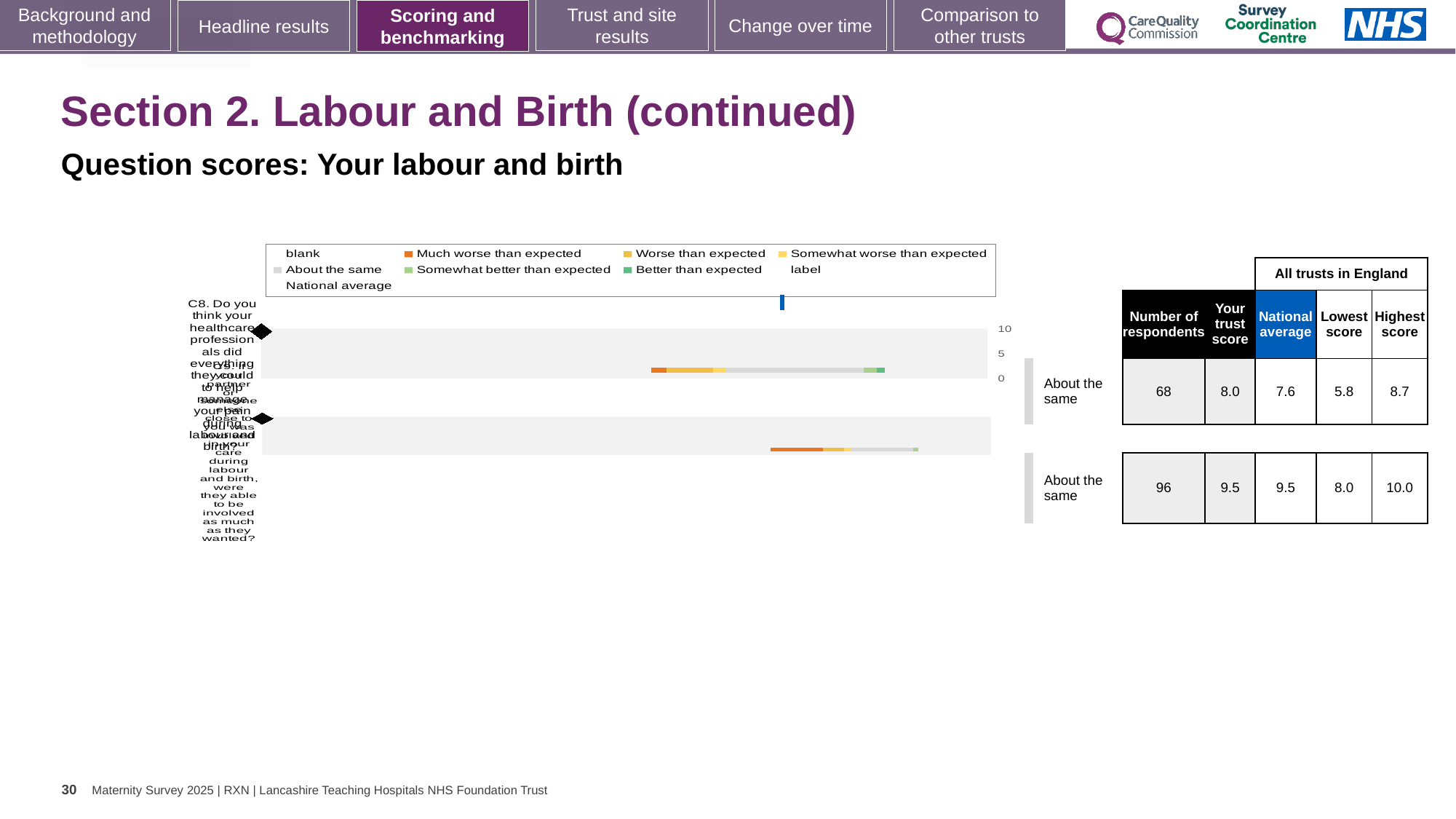
What kind of chart is shown on the slide? bar chart What benchmark category is shown for both questions on this slide? About the same What is the national average for question C8 (the first row of the table)? 7.6 For the first row of the table, which is larger: the trust's score or the national average? Your trust score In the table next to the chart, how many respondents are listed for question C8 (the first row)? 68 How many respondents are listed for the second row of the table? 96 What is the trust's score for the second row of the table? 9.5 What is the highest score across all trusts in England for the first row of the table? 8.7 What is the trust's score for question C8 (the first row of the table)? 8.0 For the first row of the table, what is the difference between the highest score and the lowest score? 2.9 In the chart legend, what colour represents 'Much worse than expected'? orange What is the lowest score across all trusts in England for the first row of the table? 5.8